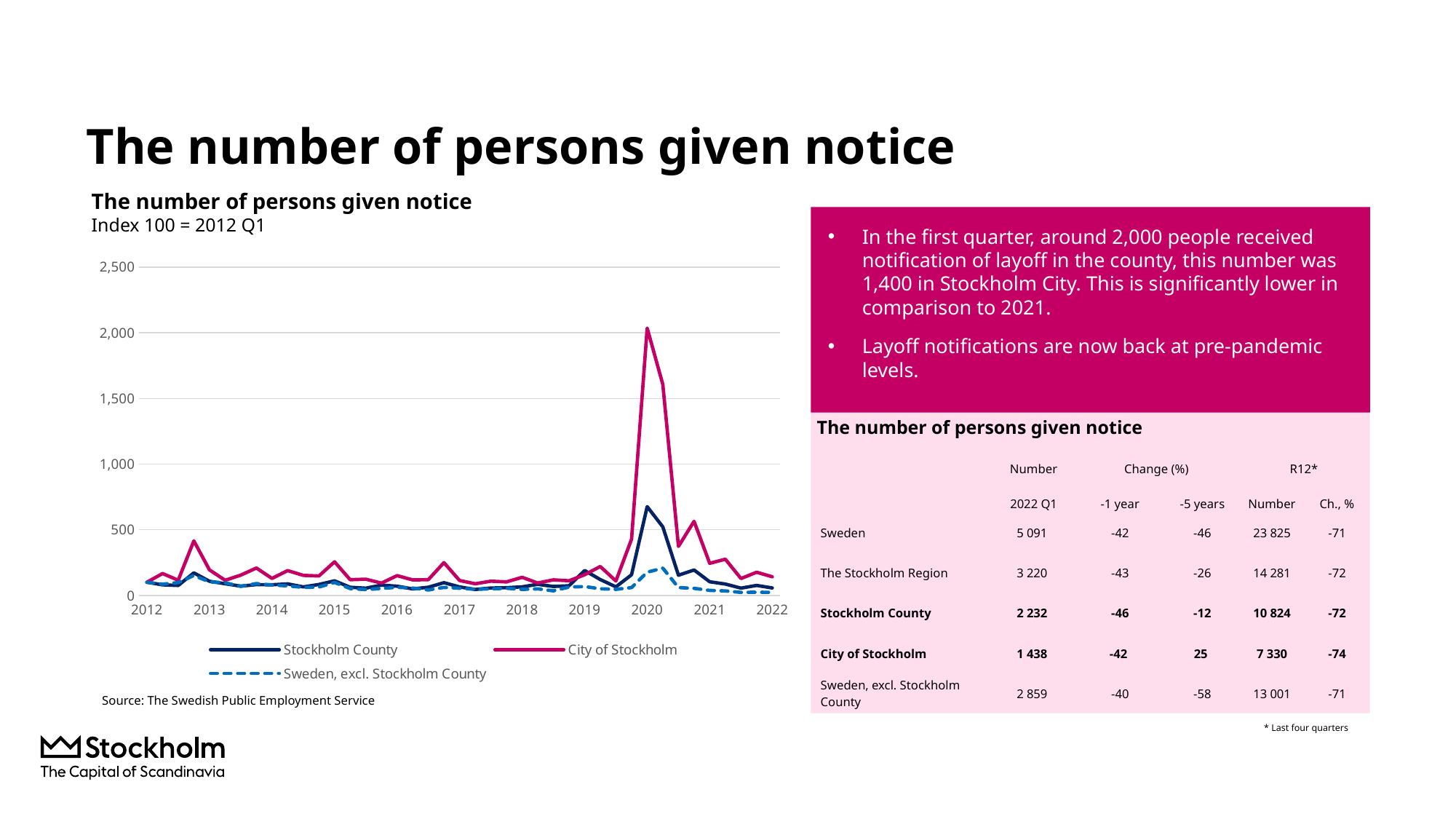
Is the value for City of Stockholm at the start of 2022 greater or less than 500? less How many year labels are shown on the x axis of the chart? 11 In 2020, which is larger: the value for City of Stockholm or the value for Stockholm County? City of Stockholm What kind of chart is shown on the slide? line chart Which series reaches the highest peak in the chart? City of Stockholm Do the values for City of Stockholm rise or fall from the 2020 peak to 2022? fall Is the peak value for City of Stockholm in 2020 greater or less than 1,500? greater How many series does the chart legend list? 3 Is the peak value for Sweden, excl. Stockholm County in 2020 greater or less than 500? less What base period does the chart's index use (Index 100 = ?) 2012 Q1 Which series stays lowest at its 2020 peak? Sweden, excl. Stockholm County